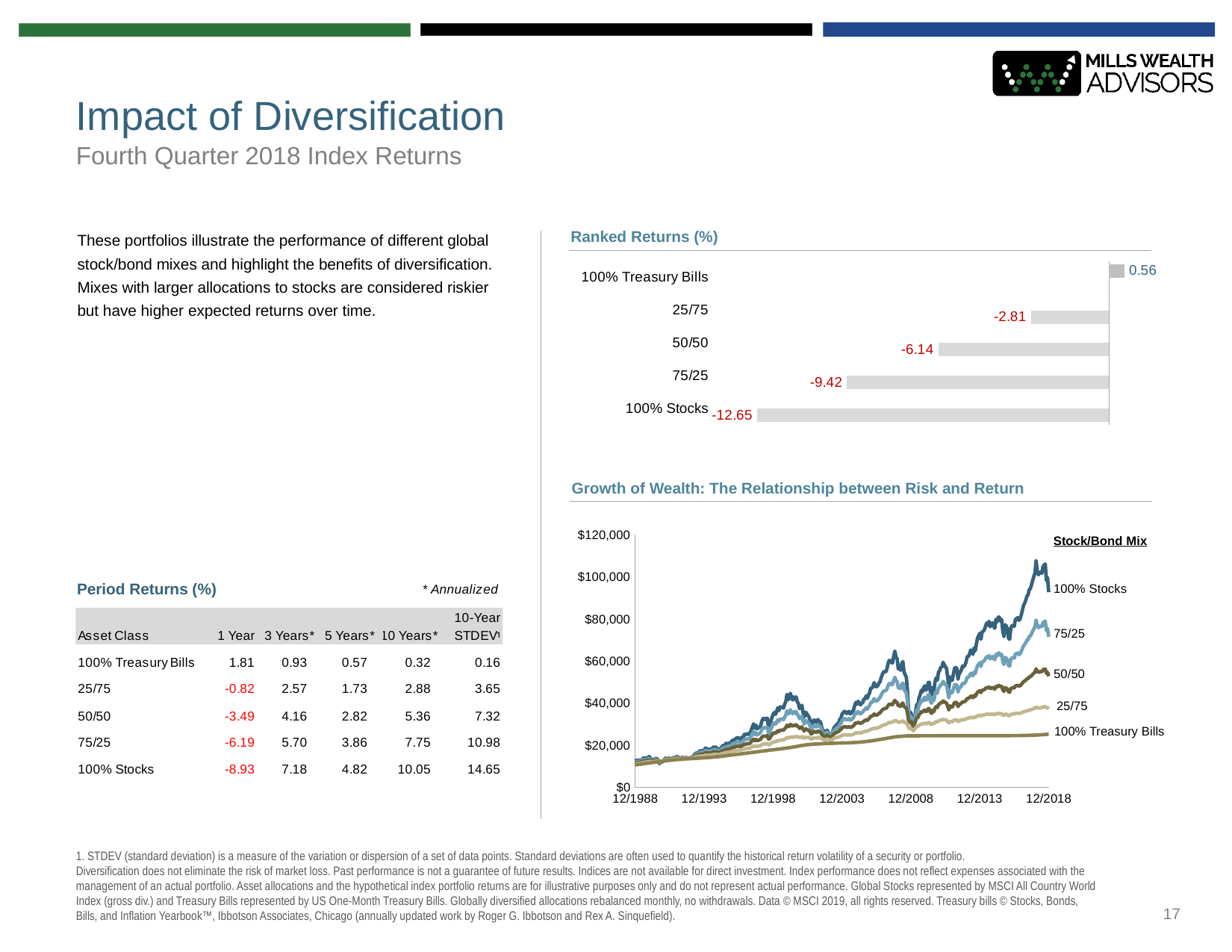
In the Ranked Returns (%) chart, what is the value for 100% Treasury Bills? 0.56 In the Ranked Returns (%) chart, which is larger, the value for 50/50 or the value for 75/25? 50/50 In the Ranked Returns (%) chart, which portfolio has the highest return? 100% Treasury Bills In the Ranked Returns (%) chart, what is the value for 100% Stocks? -12.65 In the Ranked Returns (%) chart, what is the value for 50/50? -6.14 How many stock/bond mixes are plotted in the Growth of Wealth chart? 5 In the Ranked Returns (%) chart, which portfolio has the lowest return? 100% Stocks How many portfolios are shown in the Ranked Returns (%) chart? 5 In the Growth of Wealth chart, is the value for 100% Treasury Bills at 12/2018 greater or less than $20,000? greater In the Ranked Returns (%) chart, what is the difference between the 25/75 and 75/25 values? 6.61 What kind of chart is the Ranked Returns (%) chart? Bar chart What kind of chart is the Growth of Wealth chart? Line chart